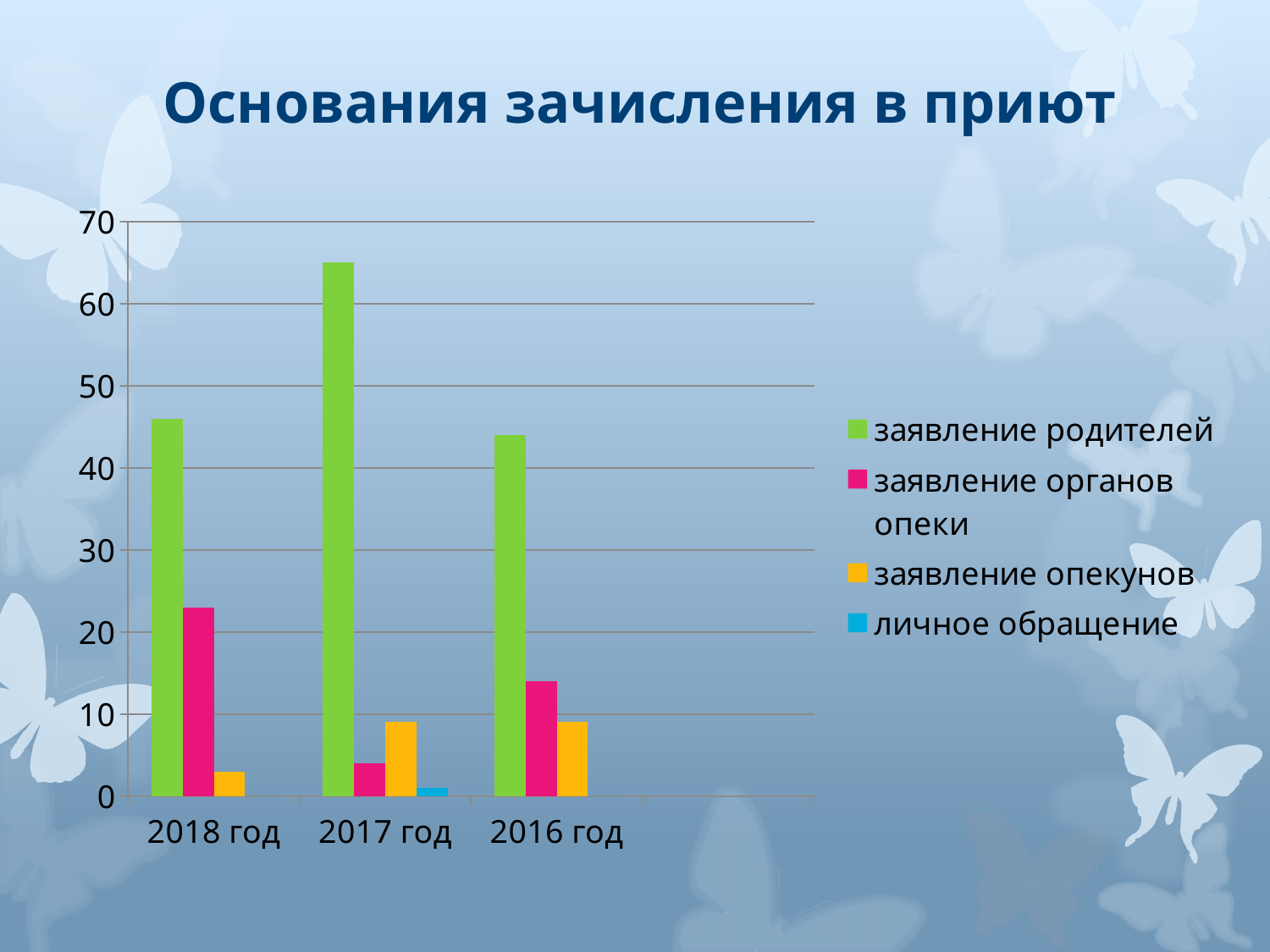
In which year is the value for "заявление родителей" the highest? 2017 год How many year categories are shown on the x axis? 3 How many series does the legend list? 4 Which colour represents the series "заявление опекунов" in the legend? yellow Is the value for "заявление органов опеки" in 2018 год greater or less than 20? greater What type of chart is shown on the slide? bar chart In which year is the value for "заявление органов опеки" the lowest? 2017 год Is the value for "заявление родителей" in 2017 год greater or less than 60? greater What is the title of the chart? Основания зачисления в приют Which is larger: "заявление родителей" in 2018 год or in 2016 год? 2018 год Which is larger in 2018 год: "заявление органов опеки" or "заявление опекунов"? заявление органов опеки